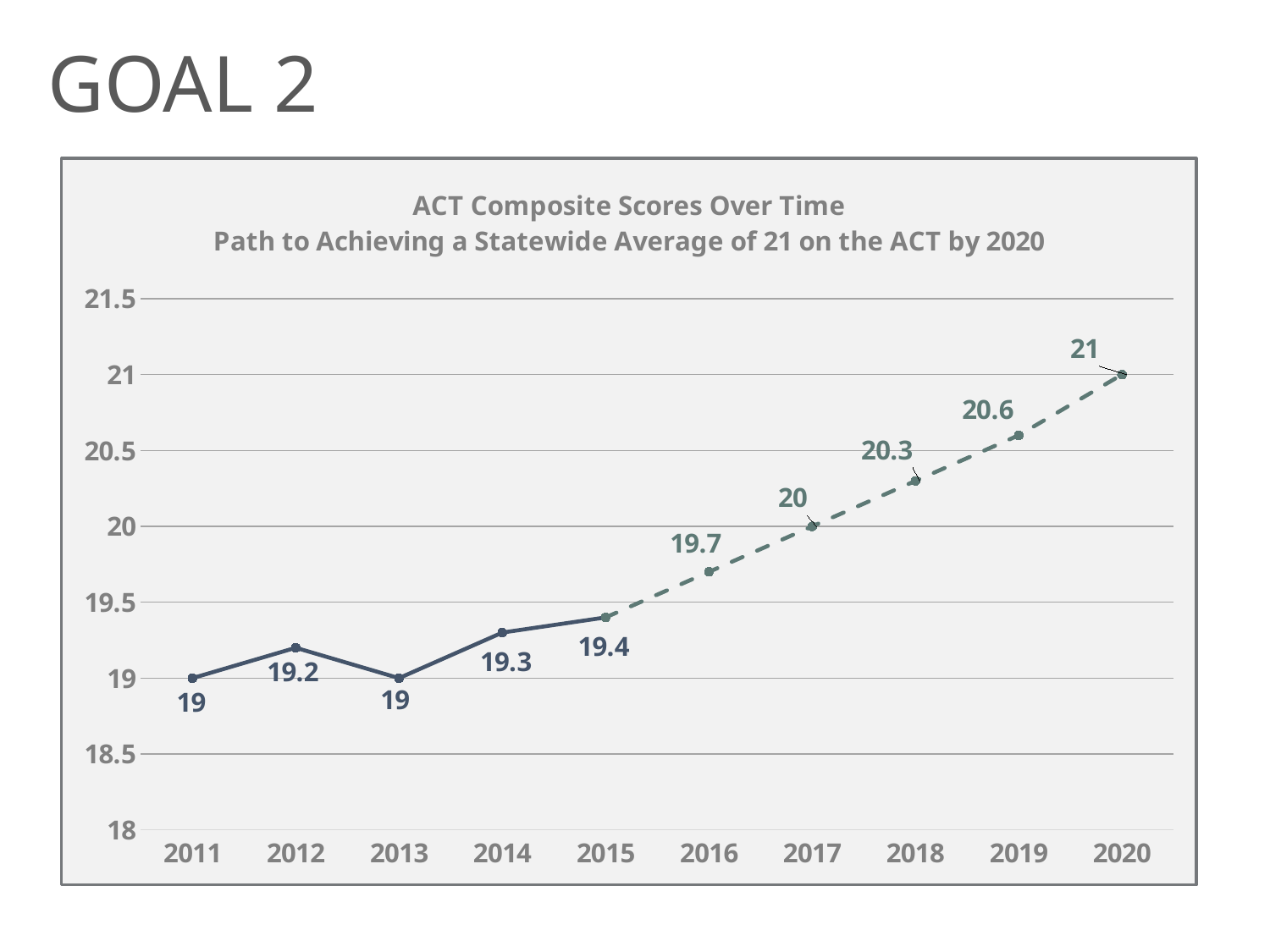
What is the difference between the values for 2014 and 2013? 0.3 What is the ACT composite score shown for 2012? 19.2 What value is plotted for 2020? 21 What kind of chart is shown on the slide? Line chart Which is larger, the value for 2012 or the value for 2013? 2012 What is the difference between the values for 2020 and 2015? 1.6 Do the values rise or fall from 2015 to 2020? Rise What is the ACT composite score shown for 2015? 19.4 Which year has the highest value on the chart? 2020 What value is plotted for 2018? 20.3 What is the title of the chart? ACT Composite Scores Over Time Path to Achieving a Statewide Average of 21 on the ACT by 2020 How many years are plotted on the x axis? 10